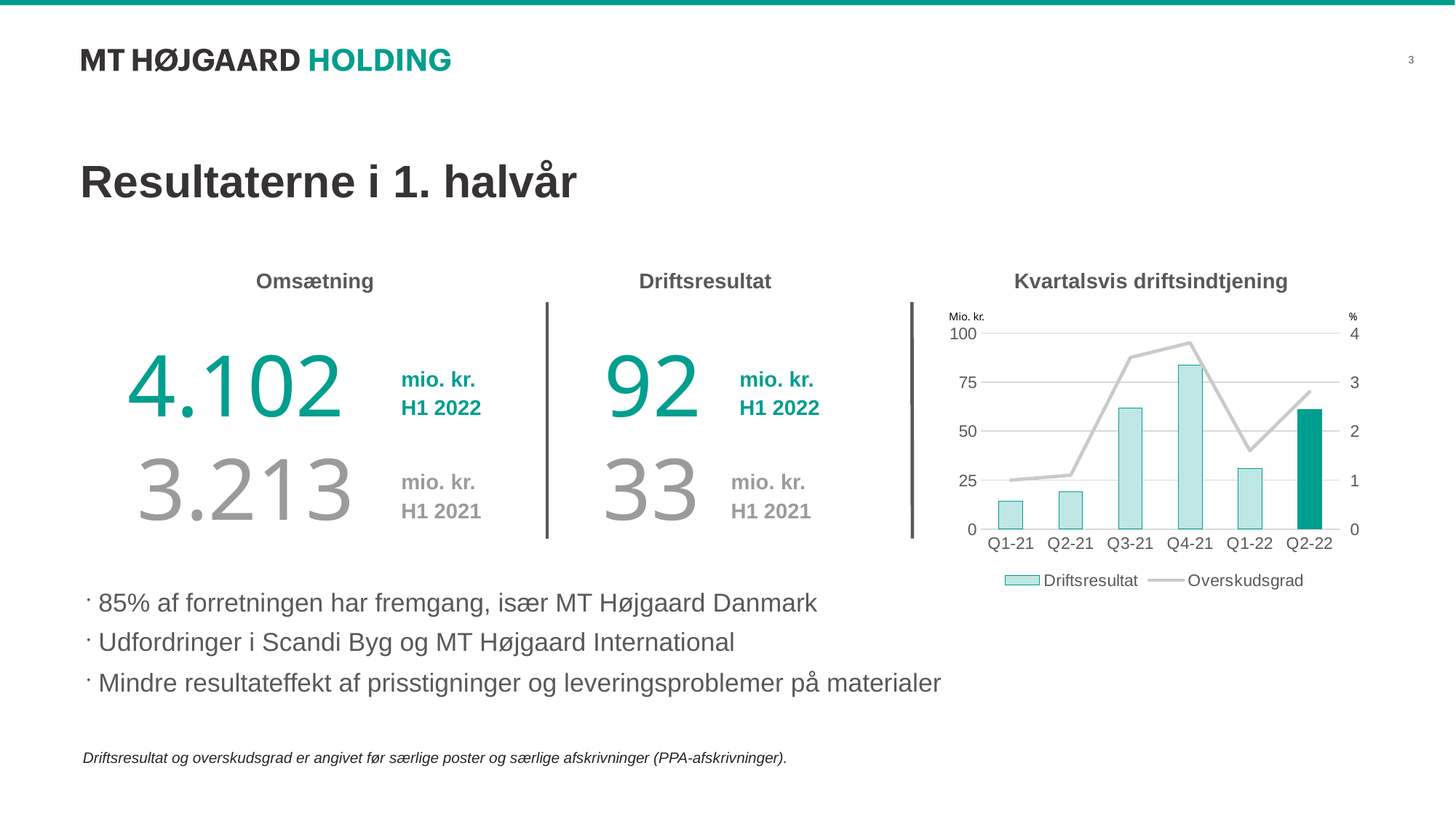
In the "Kvartalsvis driftsindtjening" chart, is the Driftsresultat for Q4-21 greater or less than 75? greater In the "Kvartalsvis driftsindtjening" chart, is the Driftsresultat for Q3-21 greater or less than 50? greater In the "Kvartalsvis driftsindtjening" chart, do the Driftsresultat bars rise or fall from Q1-21 to Q4-21? rise What kind of chart is "Kvartalsvis driftsindtjening"? A bar chart combined with a line In the "Kvartalsvis driftsindtjening" chart, which has the larger Driftsresultat bar, Q1-22 or Q2-21? Q1-22 In the "Kvartalsvis driftsindtjening" chart, is the Overskudsgrad for Q4-21 greater or less than 3%? greater In the "Kvartalsvis driftsindtjening" chart, which quarter has the lowest Driftsresultat bar? Q1-21 What are the two legend entries of the "Kvartalsvis driftsindtjening" chart? Driftsresultat and Overskudsgrad In the "Kvartalsvis driftsindtjening" chart, which quarter has the highest Driftsresultat bar? Q4-21 How many series does the legend of the "Kvartalsvis driftsindtjening" chart list? 2 How many quarters are shown on the x axis of the "Kvartalsvis driftsindtjening" chart? 6